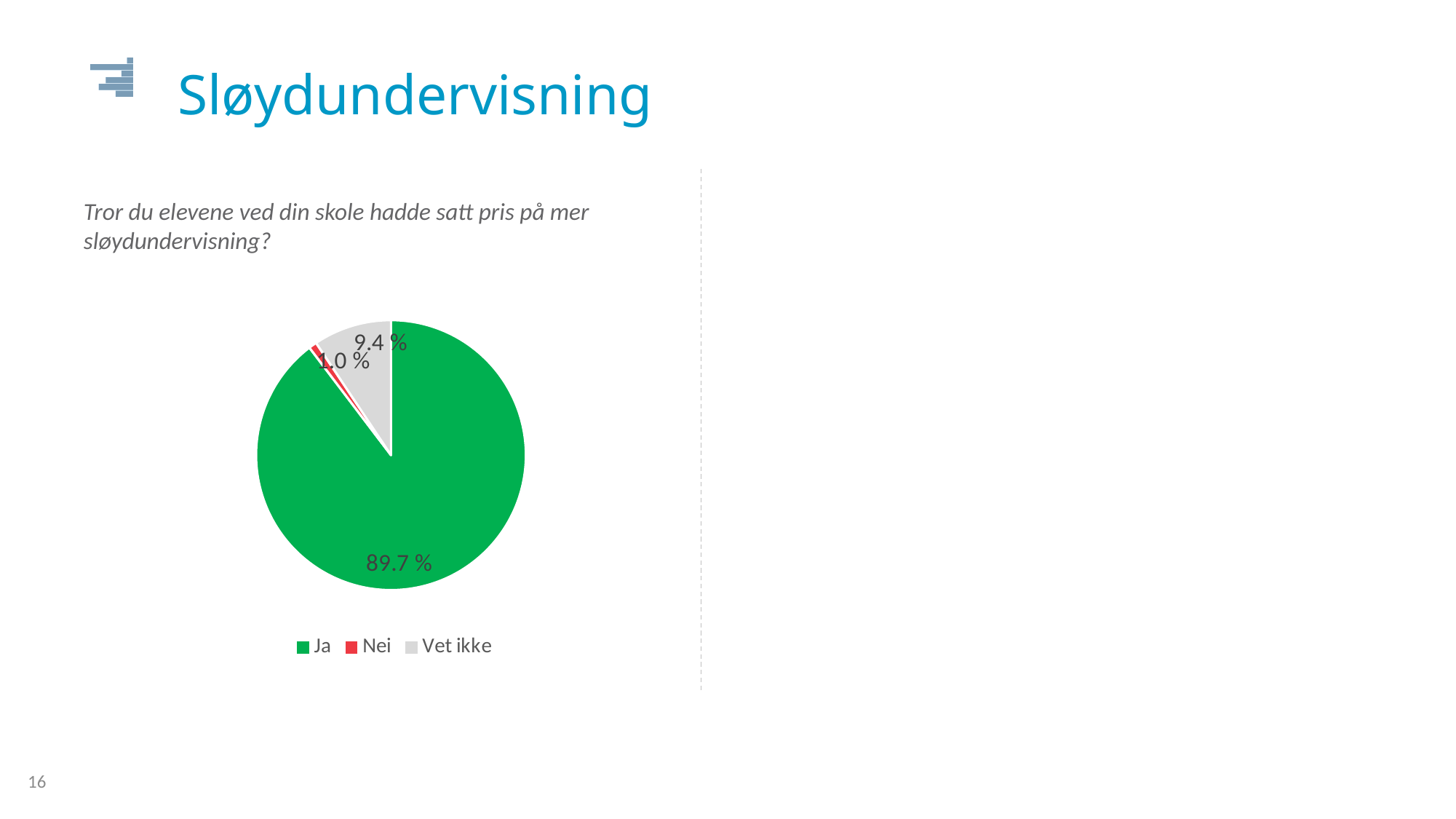
Which is larger, the share for "Vet ikke" or the share for "Nei"? Vet ikke What share of respondents answered "Nei"? 1.0 % What kind of chart is shown on the slide? pie chart What share of respondents answered "Ja"? 89.7 % How many categories does the pie chart show? 3 Which answer has the largest slice of the pie? Ja What share of respondents answered "Vet ikke"? 9.4 % What is the difference in percentage points between "Ja" and "Vet ikke"? 80.3 How many entries does the legend list? 3 Which answer has the smallest slice of the pie? Nei What question is the pie chart answering, as written above it? Tror du elevene ved din skole hadde satt pris på mer sløydundervisning? What colour is the "Ja" slice? green